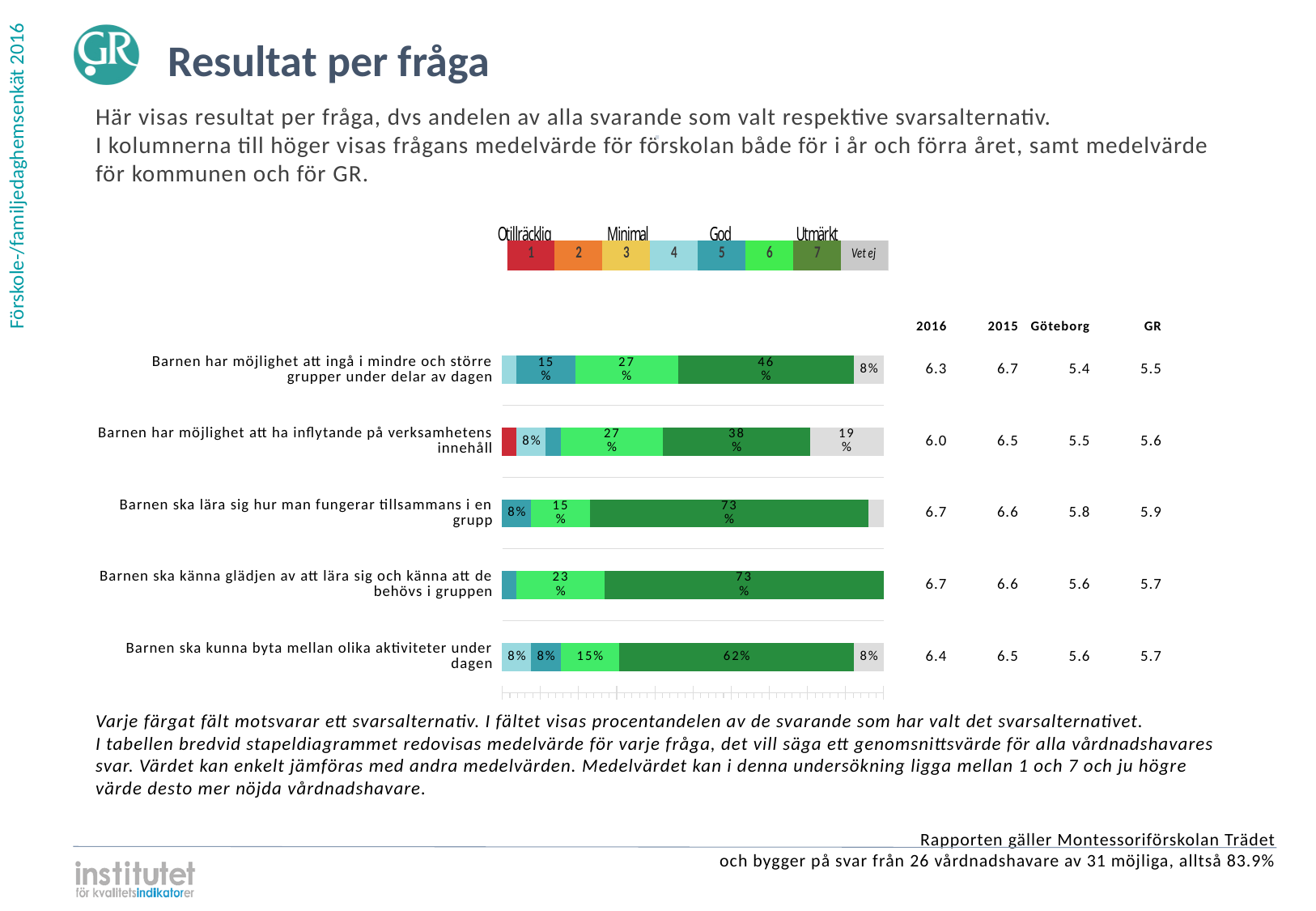
What are the four named scale levels shown in the legend above the chart? Otillräcklig, Minimal, God, Utmärkt What percentage chose 7 (Utmärkt) for 'Barnen ska lära sig hur man fungerar tillsammans i en grupp'? 73% What percentage chose 7 (Utmärkt) for 'Barnen ska kunna byta mellan olika aktiviteter under dagen'? 62% Which is larger: the share choosing 6 for 'Barnen har möjlighet att ingå i mindre och större grupper under delar av dagen' or for 'Barnen ska känna glädjen av att lära sig och känna att de behövs i gruppen'? Barnen har möjlighet att ingå i mindre och större grupper under delar av dagen (27%) What percentage of respondents chose 7 (Utmärkt) for 'Barnen har möjlighet att ingå i mindre och större grupper under delar av dagen'? 46% How many questions (bars) are shown in the chart? 5 What is the 2016 mean value shown for 'Barnen har möjlighet att ingå i mindre och större grupper under delar av dagen'? 6.3 What kind of chart is shown on the slide? Stacked bar chart How many percentage points higher is the share choosing 7 for 'Barnen ska lära sig hur man fungerar tillsammans i en grupp' (73%) than for 'Barnen har möjlighet att ingå i mindre och större grupper under delar av dagen' (46%)? 27 percentage points What is the 'Vet ej' share for 'Barnen har möjlighet att ha inflytande på verksamhetens innehåll'? 19% Which question has the lowest share of respondents choosing 7 (Utmärkt)? Barnen har möjlighet att ha inflytande på verksamhetens innehåll Which question has the largest 'Vet ej' share? Barnen har möjlighet att ha inflytande på verksamhetens innehåll